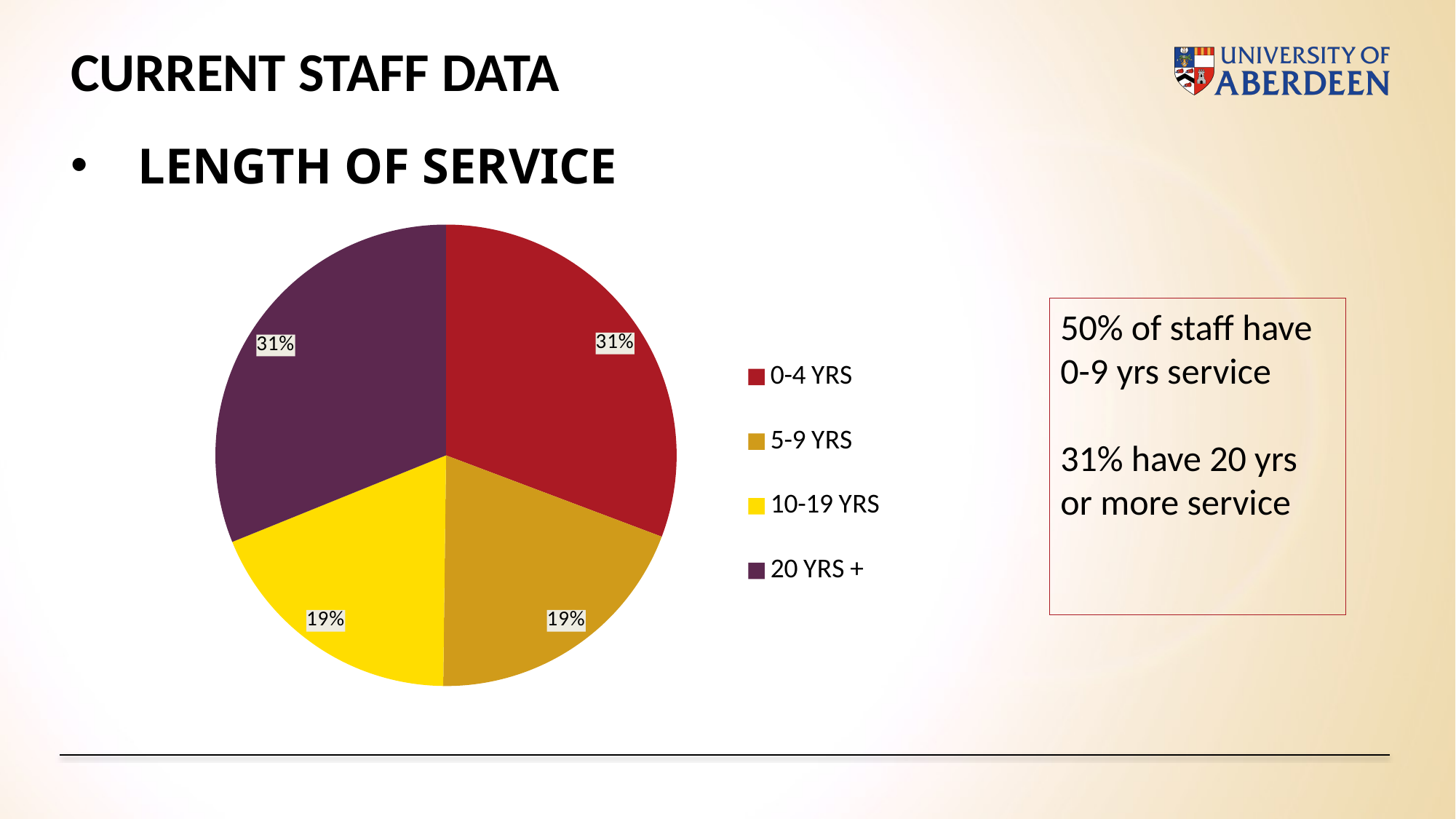
What is the combined share of the 0-4 YRS and 5-9 YRS slices? 50% What kind of chart is shown on the slide? Pie chart What is the difference in percentage points between the 0-4 YRS slice and the 10-19 YRS slice? 12 Which is larger, the share for 0-4 YRS or the share for 5-9 YRS? 0-4 YRS How many slices does the pie chart have? 4 Which category is shown in dark purple in the pie chart? 20 YRS + What share of staff have 0-4 years of service? 31% What share of staff have 20 or more years of service? 31% Which is larger, the share for 10-19 YRS or the share for 20 YRS +? 20 YRS + What share of staff have 10-19 years of service? 19% What share of staff have 5-9 years of service? 19% Which colour represents the 10-19 YRS category in the pie chart? Yellow